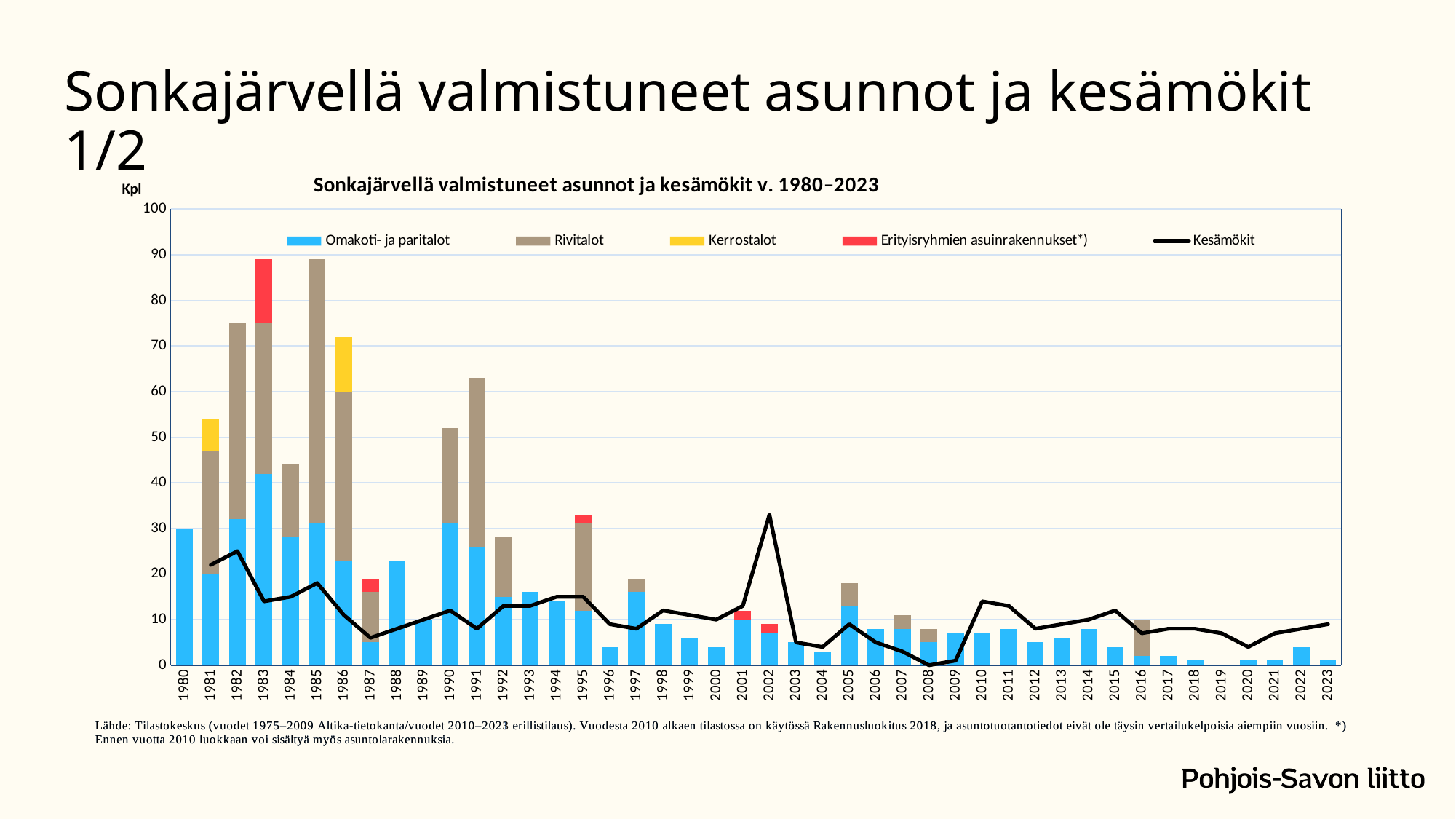
Which colour represents Kerrostalot in the legend? Yellow Do the stacked bar totals generally rise or fall from 1980 to 2023? fall Which year has the higher Kesämökit value, 2002 or 2003? 2002 Is the total height of the stacked bar for 1982 greater or less than 70? greater Is the Kesämökit value for 2002 greater or less than 30? greater Is the total height of the stacked bar for 1991 greater or less than 60? greater What kind of chart is shown on the slide? A stacked bar chart with a line series How many series does the legend list? 5 In which year does the Kesämökit line reach its highest value? 2002 How many years are shown along the x axis? 44 Which year has the taller stacked bar, 1982 or 1984? 1982